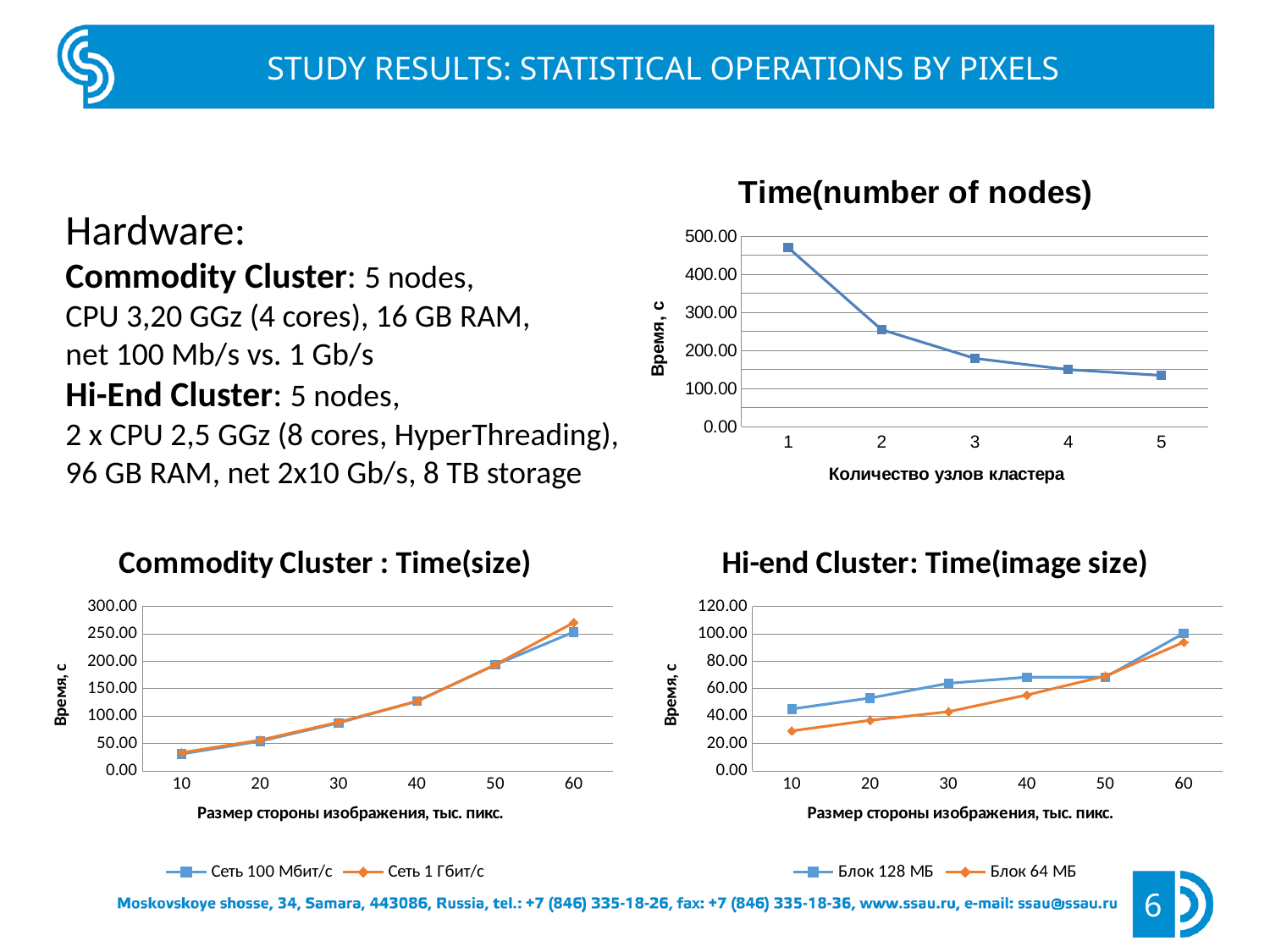
In the 'Commodity Cluster : Time(size)' chart, is the value for 'Сеть 1 Гбит/с' at 60 greater or less than 250? greater In the 'Time(number of nodes)' chart, what type of chart is shown? line chart In the 'Time(number of nodes)' chart, is the value for 1 node greater or less than 400? greater In the 'Hi-end Cluster: Time(image size)' chart, what are the two series listed in the legend? Блок 128 МБ and Блок 64 МБ In the 'Hi-end Cluster: Time(image size)' chart, which series has the larger value at 10: 'Блок 128 МБ' or 'Блок 64 МБ'? Блок 128 МБ In the 'Hi-end Cluster: Time(image size)' chart, is the value for 'Блок 64 МБ' at 10 greater or less than 40? less In the 'Commodity Cluster : Time(size)' chart, how many series does the legend list? 2 In the 'Time(number of nodes)' chart, does the time rise or fall as the number of nodes increases? fall In the 'Commodity Cluster : Time(size)' chart, does the time rise or fall as the image side size increases? rise In the 'Time(number of nodes)' chart, how many data points are plotted? 5 In the 'Time(number of nodes)' chart, which number of nodes has the highest time? 1